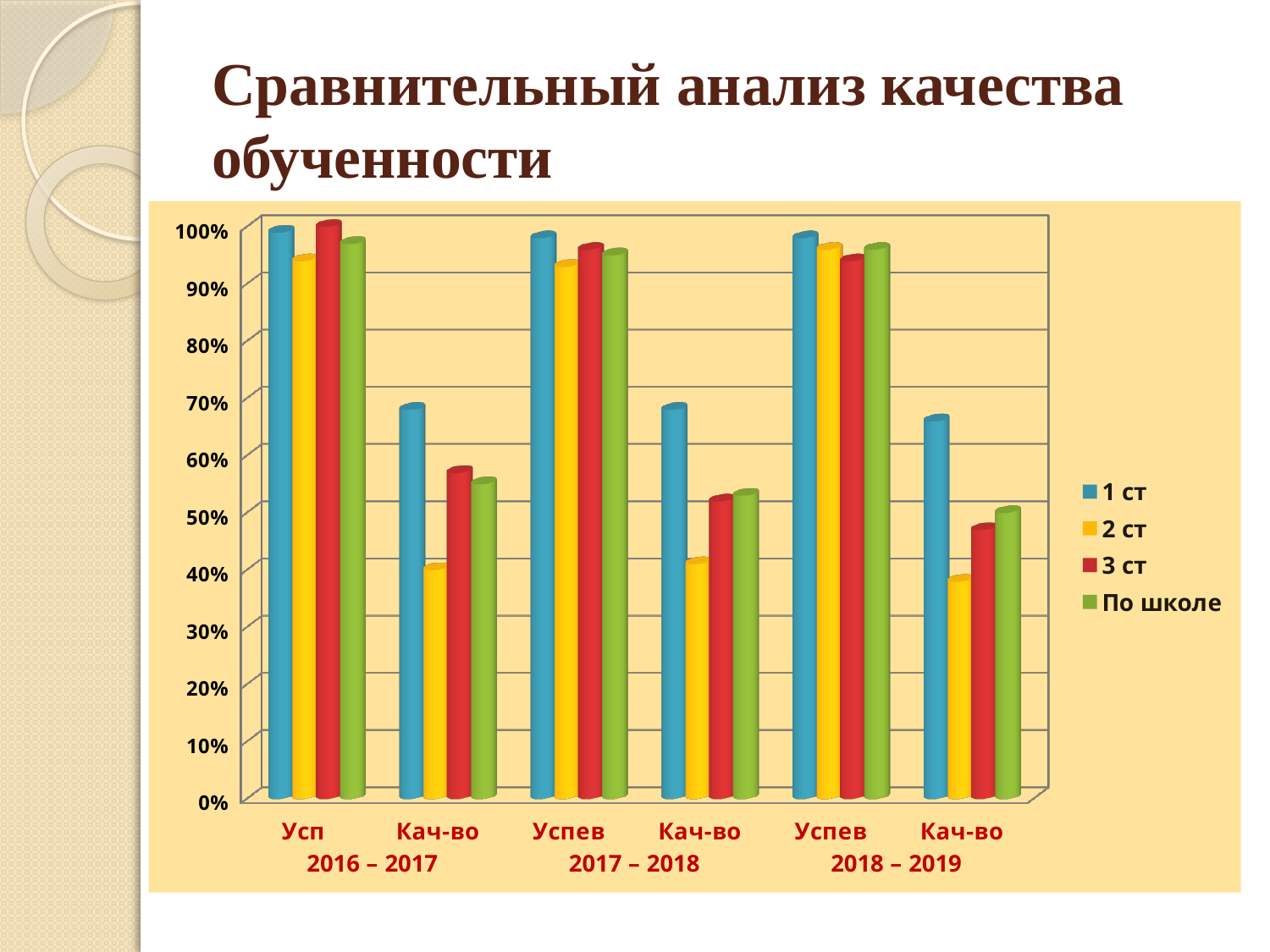
Is the value for 3 ст in Кач-во 2018 – 2019 greater or less than 60%? less What is the title of the slide containing the chart? Сравнительный анализ качества обученности Which series has the lowest value in Кач-во 2017 – 2018? 2 ст Which series has the highest value in Кач-во 2018 – 2019? 1 ст What kind of chart is shown on the slide? bar chart Is the value for 1 ст in Кач-во 2016 – 2017 greater or less than 60%? greater How many categories are shown along the x axis? 6 In Кач-во 2016 – 2017, which is larger: the value for 1 ст or the value for 2 ст? 1 ст Is the value for 1 ст in Успев 2017 – 2018 greater or less than 90%? greater How many series does the legend list? 4 What are the series names listed in the legend? 1 ст, 2 ст, 3 ст, По школе